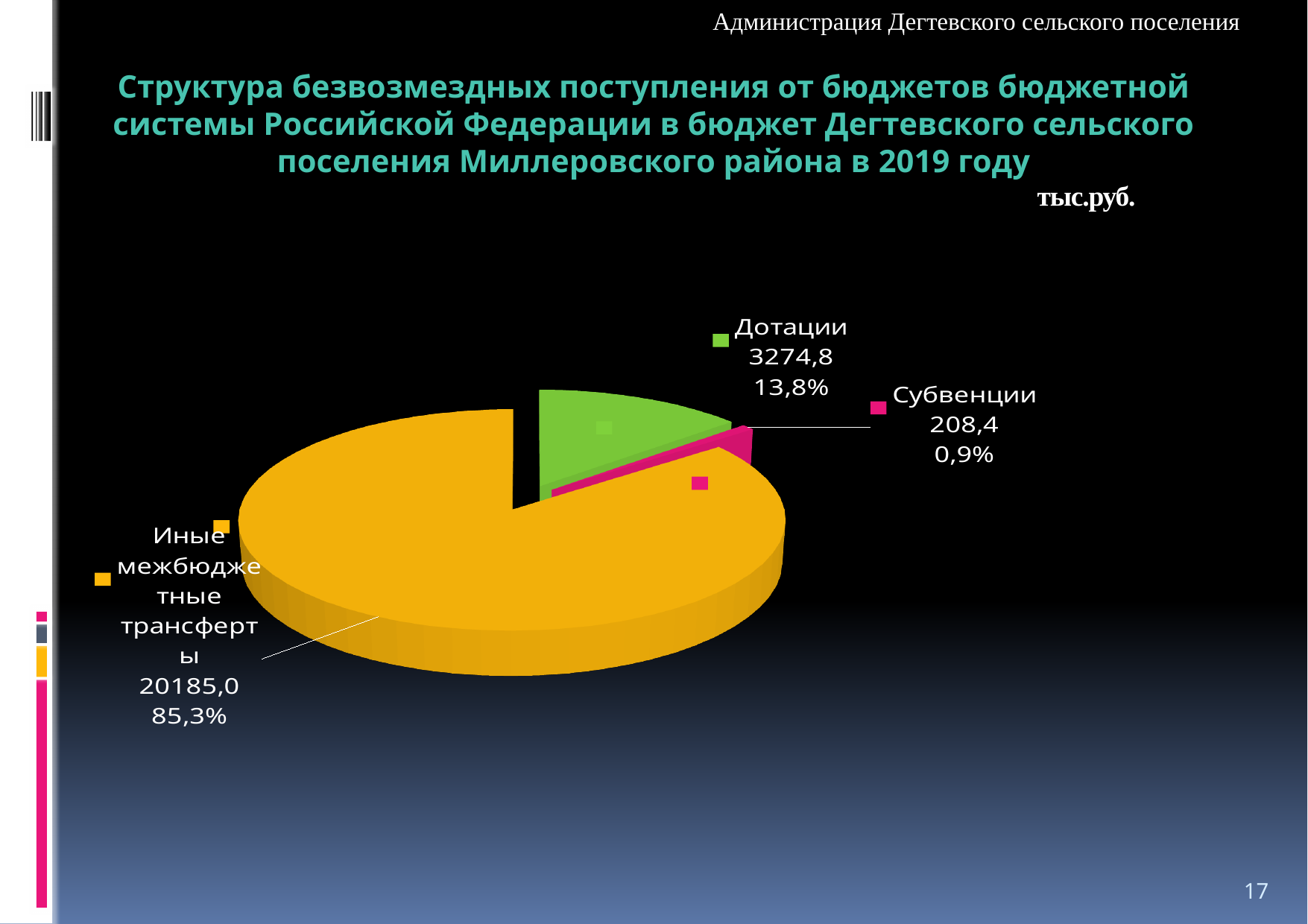
What kind of chart is shown on the slide? pie chart Which category has the largest slice? Иные межбюджетные трансферты Which is larger, Дотации or Субвенции? Дотации What share of the pie does Иные межбюджетные трансферты represent? 85,3% What is the value for Дотации? 3274,8 Which category has the smallest slice? Субвенции What share of the pie does Дотации represent? 13,8% What unit of measurement is indicated for the chart values? тыс.руб. How many slices does the pie chart have? 3 What share of the pie does Субвенции represent? 0,9% What is the value for Субвенции? 208,4 What is the value for Иные межбюджетные трансферты? 20185,0